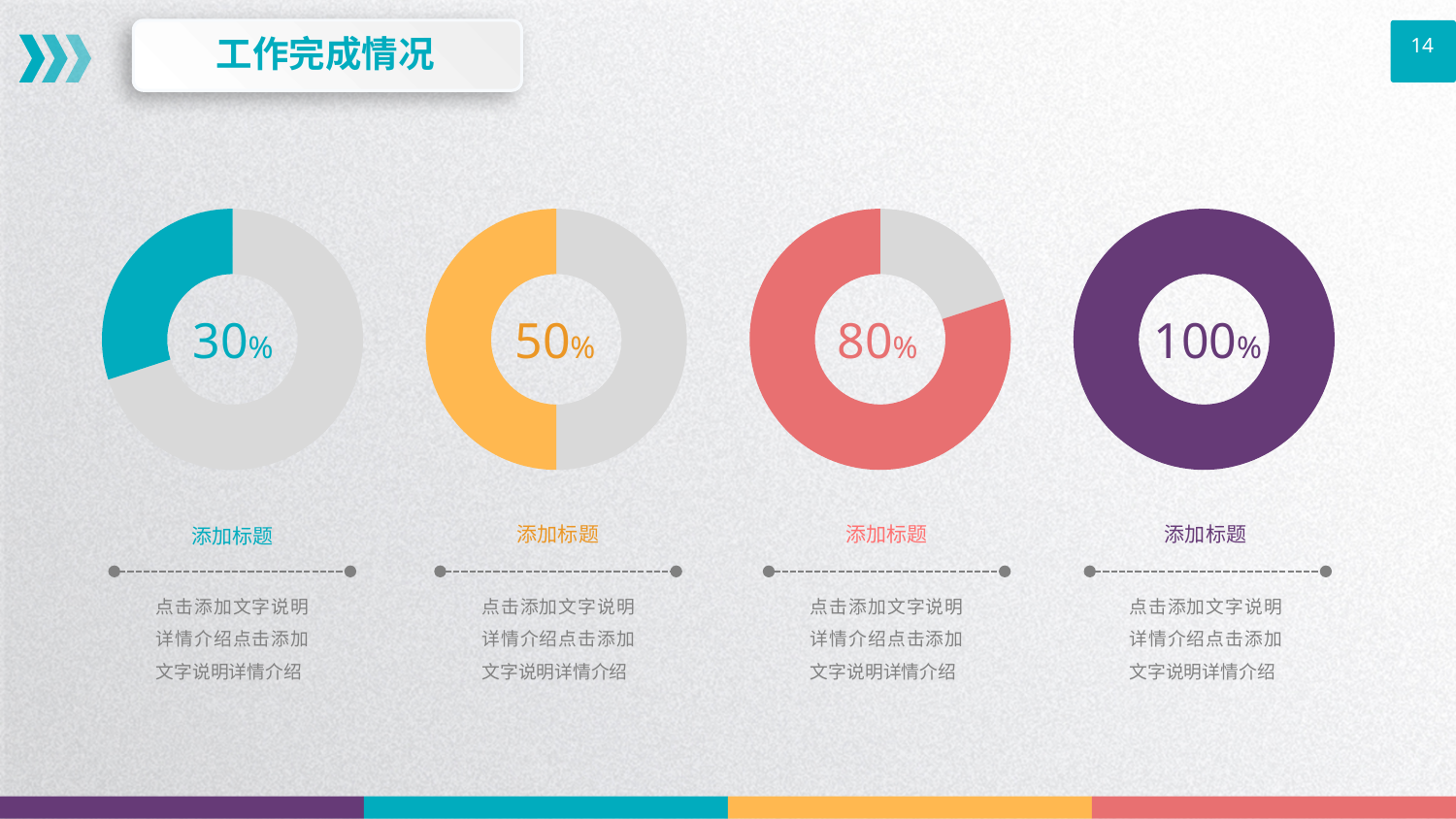
Which is larger: the value in the second (orange) donut chart or the value in the third (red) donut chart? The third (red) chart, 80% How many donut charts are on the slide? 4 What value is shown in the centre of the second (orange) donut chart from the left? 50% What value is shown in the centre of the rightmost (purple) donut chart? 100% What value is shown in the centre of the leftmost (teal) donut chart? 30% Do the percentages in the donut charts increase or decrease from left to right across the slide? Increase Which donut chart shows the lowest percentage? The leftmost (teal) chart, 30% What value is shown in the centre of the third (red) donut chart from the left? 80% What is the difference between the percentage in the third (red) donut chart and the leftmost (teal) donut chart? 50% Which donut chart shows the highest percentage? The rightmost (purple) chart, 100% What kind of chart is used to show each percentage on the slide? Donut (pie) chart What is the title of the slide containing the donut charts? 工作完成情况